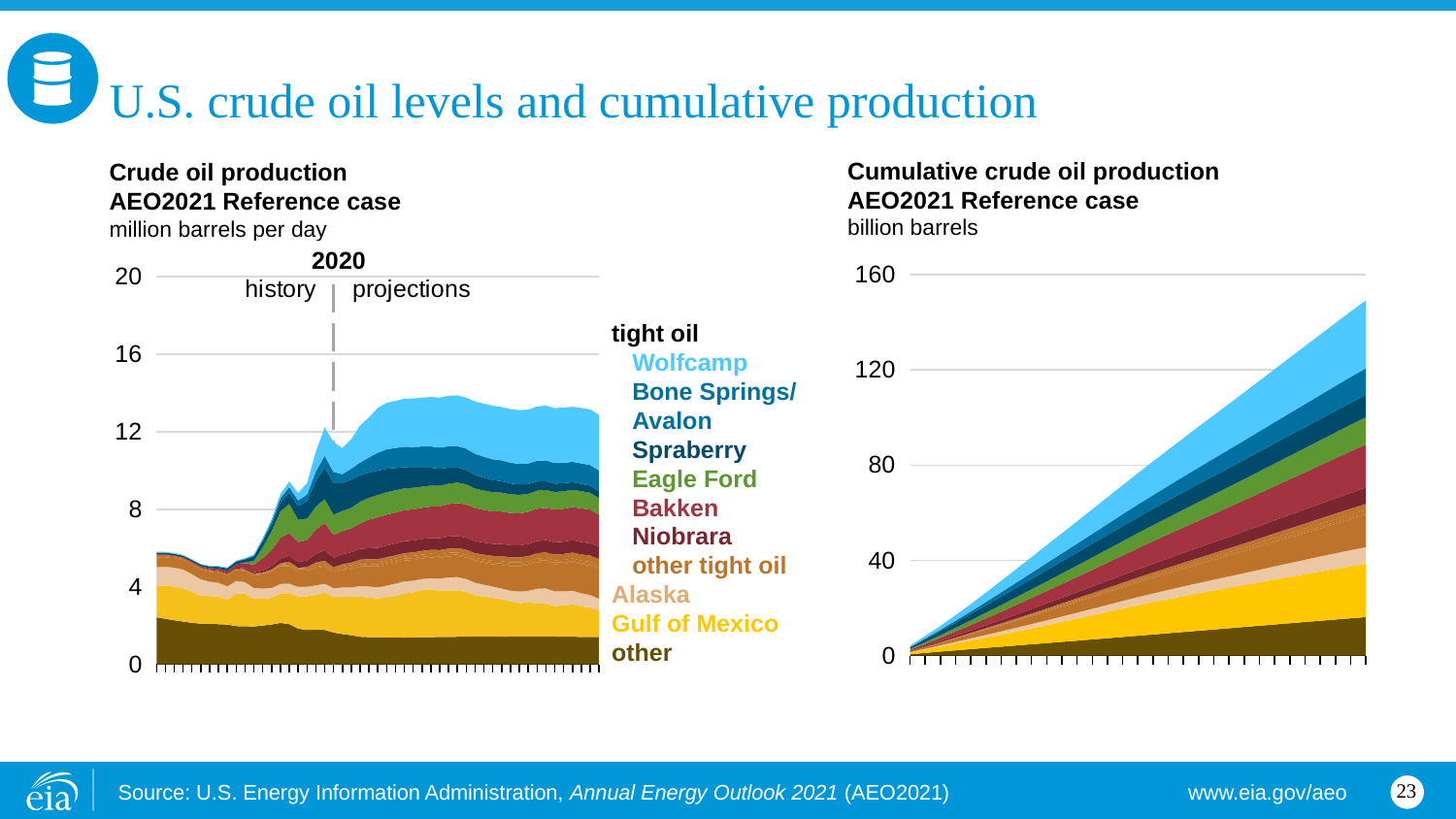
In the 'Crude oil production' chart, is the total production at the left end of the history period greater or less than 8? less In the 'Cumulative crude oil production' chart, does the total rise or fall along the x axis? rise What kind of chart is the 'Cumulative crude oil production' chart on the right? stacked area chart In the 'Crude oil production' chart, which year separates history from projections? 2020 What unit is used on the y axis of the 'Cumulative crude oil production' chart? billion barrels How many series does the legend list for the 'Crude oil production' chart? 10 What kind of chart is the 'Crude oil production' chart on the left? stacked area chart In the 'Crude oil production' chart, is the total production at the right end of the projection period greater or less than 16? less What unit is used on the y axis of the 'Crude oil production' chart? million barrels per day In the 'Crude oil production' chart, is the total production at the right end of the projection period greater or less than 12? greater